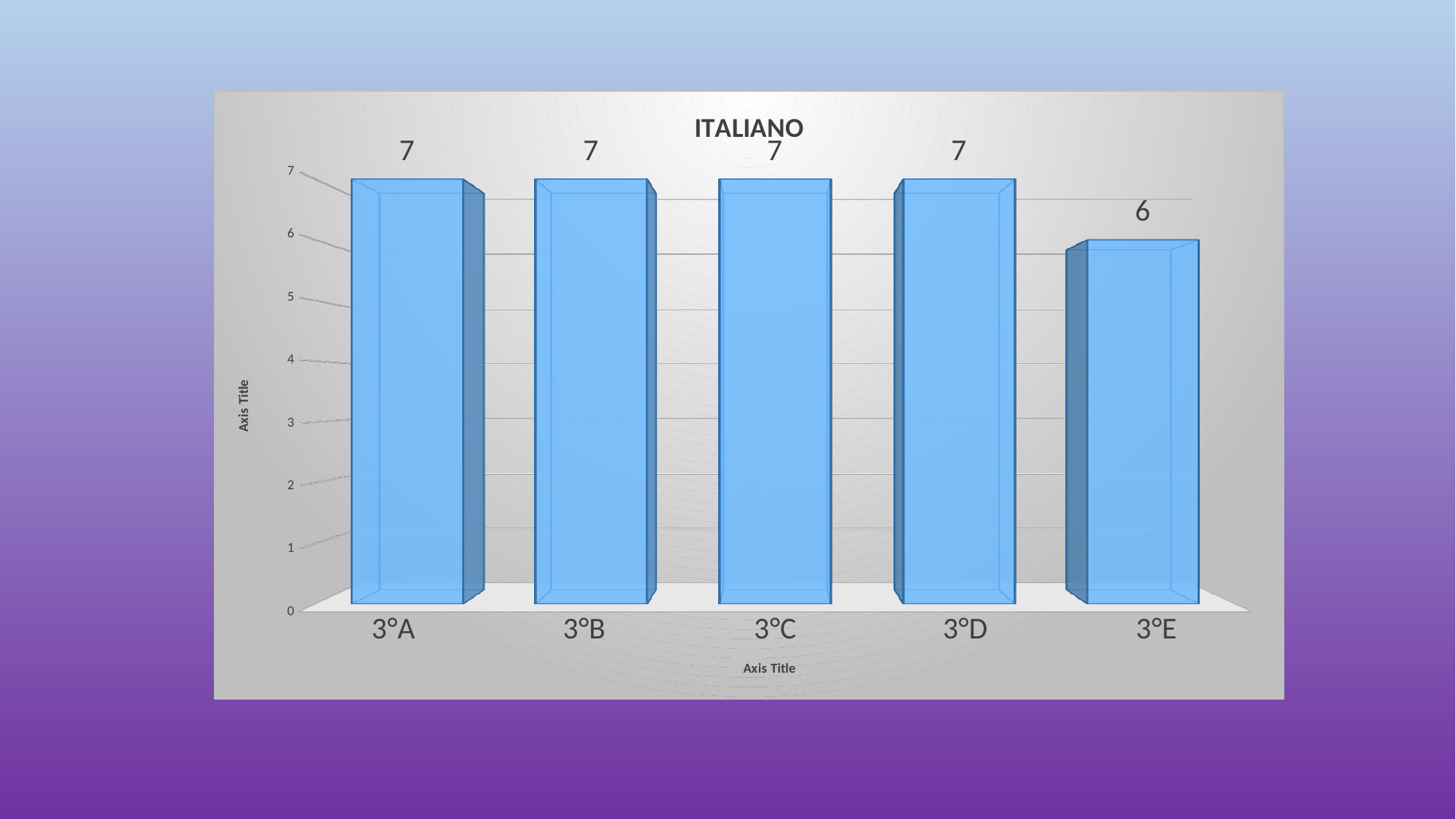
What is the title of the chart? ITALIANO How many categories are shown on the x axis? 5 Is the value for 3°E greater or less than 5? greater Which category has the lowest value? 3°E What is the value for 3°C? 7 What kind of chart is shown on the slide? bar chart What is the highest value shown on the vertical axis? 7 Which is larger, the value for 3°B or the value for 3°E? 3°B How many categories have a value of 7? 4 What is the difference between the values for 3°D and 3°E? 1 What is the value for 3°A? 7 What is the value for 3°E? 6